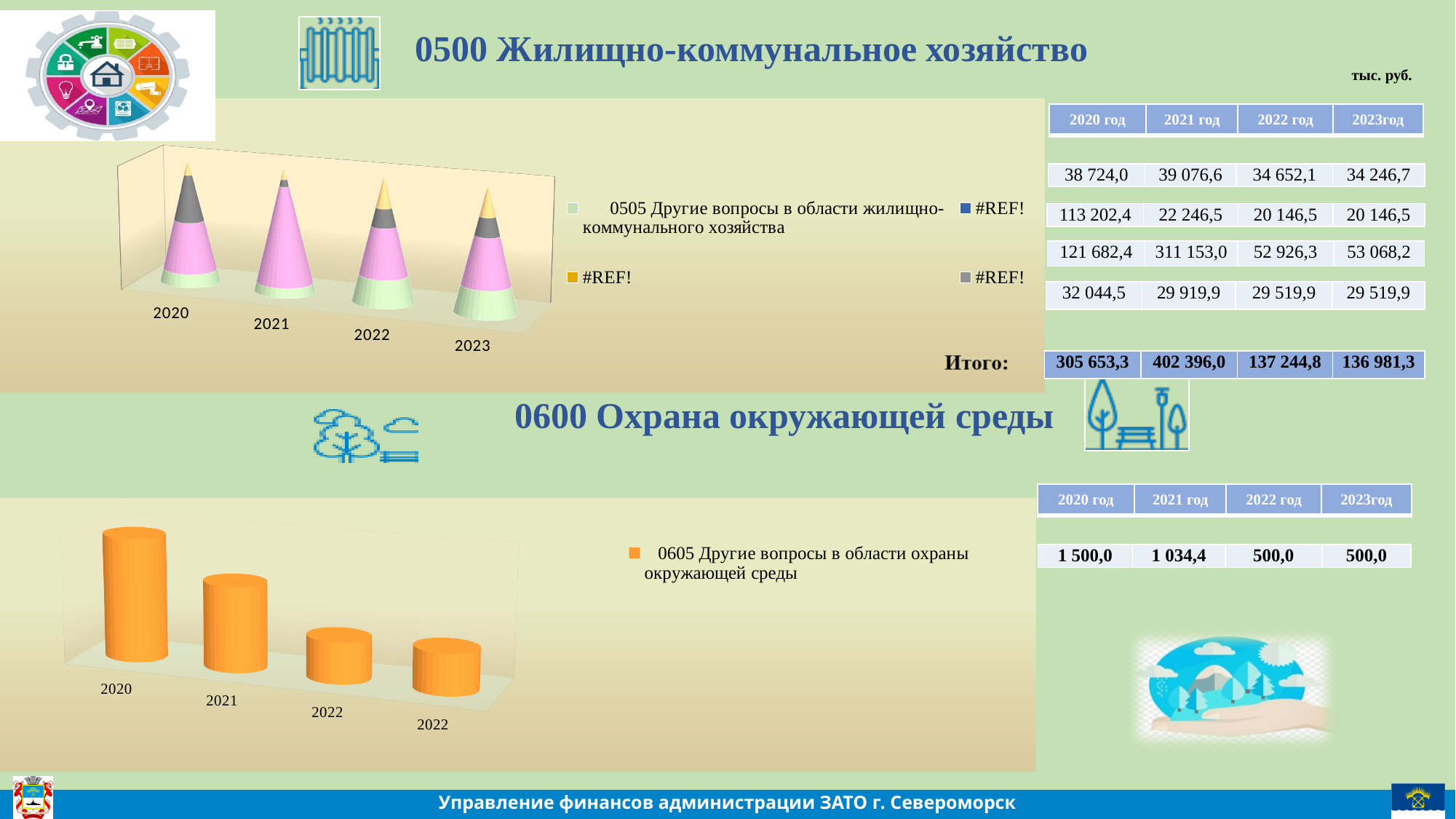
On the bottom chart (0600 Охрана окружающей среды), what is the value for 2020? 1 500,0 On the bottom chart (0600 Охрана окружающей среды), what is the value for 2021? 1 034,4 What is the legend entry for the series on the bottom chart (0600 Охрана окружающей среды)? 0605 Другие вопросы в области охраны окружающей среды On the bottom chart (0600 Охрана окружающей среды), which is larger, the value for 2020 or the value for 2021? 2020 What kind of chart is the bottom chart (0600 Охрана окружающей среды)? bar chart On the bottom chart (0600 Охрана окружающей среды), which year has the highest value? 2020 On the bottom chart (0600 Охрана окружающей среды), do the values rise or fall from left to right along the x axis? fall How many bars are plotted on the bottom chart (0600 Охрана окружающей среды)? 4 How many categories are shown on the x axis of the top chart (0500 Жилищно-коммунальное хозяйство)? 4 On the bottom chart (0600 Охрана окружающей среды), what is the difference between the 2020 and 2021 values? 465,6 How many entries does the legend of the top chart (0500 Жилищно-коммунальное хозяйство) list? 4 How many series does the legend of the bottom chart (0600 Охрана окружающей среды) list? 1